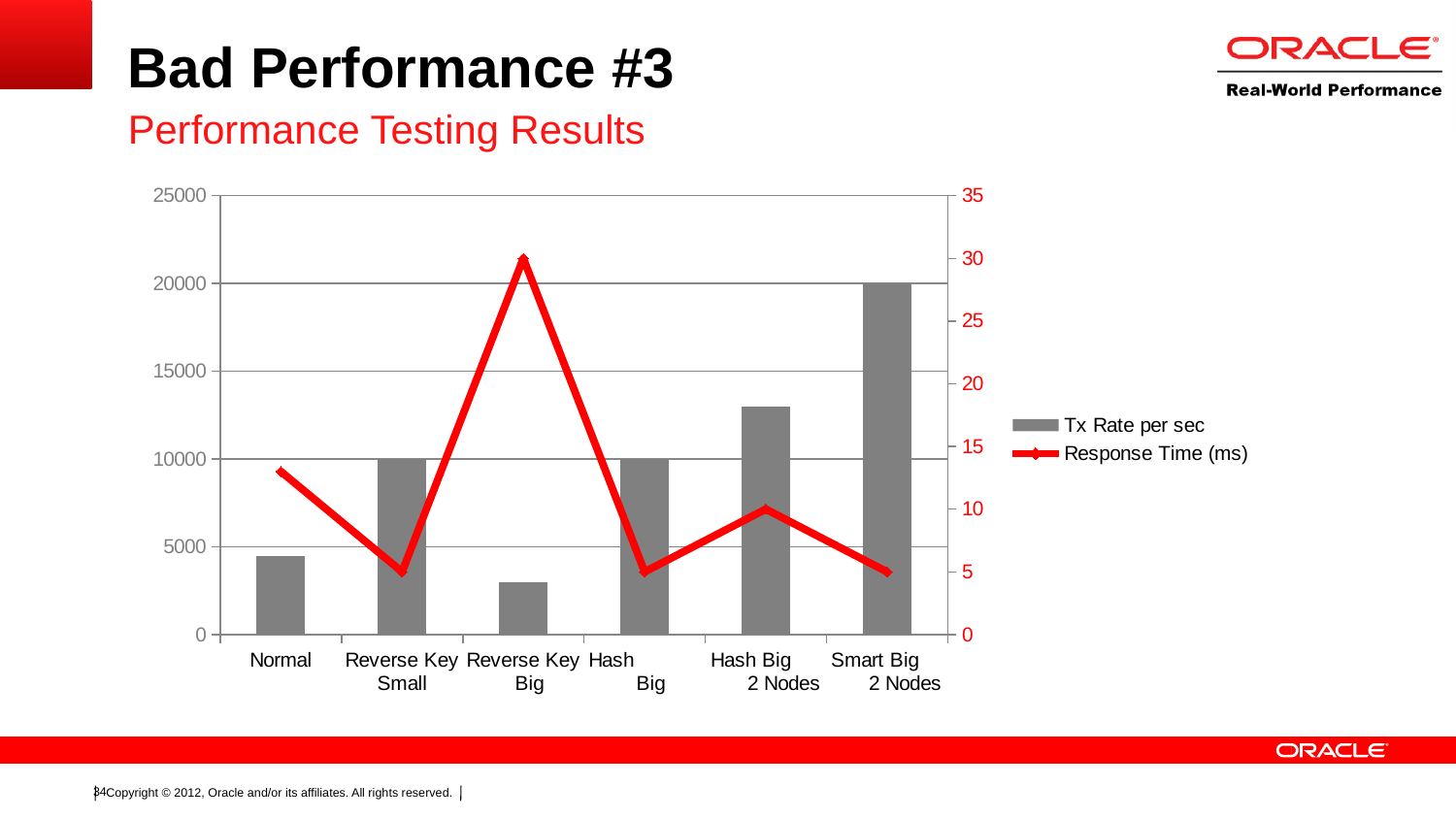
What is the Response Time (ms) for Reverse Key Big? 30 How many categories are shown on the x axis of the chart? 6 What is the Tx Rate per sec for Smart Big 2 Nodes? 20000 What is the difference in Tx Rate per sec between Smart Big 2 Nodes and Hash Big? 10000 How many series does the chart's legend list? 2 What kind of chart is shown on the slide? A combination bar and line chart Which category has the highest Response Time (ms)? Reverse Key Big What is the Tx Rate per sec for Hash Big? 10000 Is the Tx Rate per sec for Normal greater or less than 5000? less Which category has the lowest Tx Rate per sec? Reverse Key Big Which category has the highest Tx Rate per sec? Smart Big 2 Nodes What is the Response Time (ms) for Hash Big 2 Nodes? 10